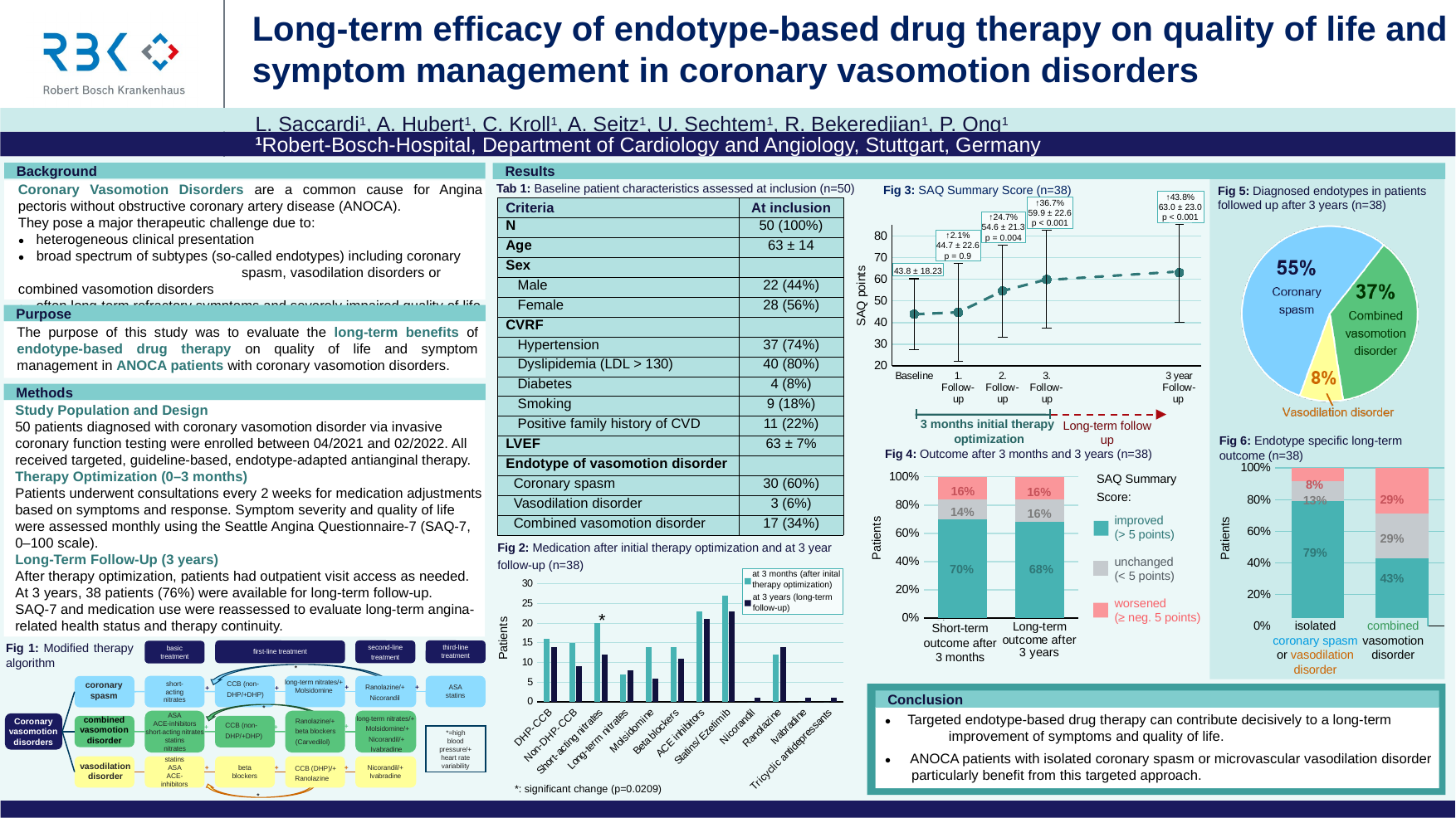
In Fig 3, what is the SAQ Summary Score at baseline? 43.8 ± 18.23 In Fig 5, which endotype has the smallest share of the pie? Vasodilation disorder How many series does the legend of Fig 4 list? 3 In Fig 4, what is the difference between the improved share in the short-term outcome (3 months) and the long-term outcome (3 years)? 2% In Fig 6, what percentage of patients with combined vasomotion disorder had a worsened outcome? 29% In Fig 2, is the number of patients on Statins/Ezetimib at 3 months greater or less than 25? greater How many slices does the pie chart in Fig 5 have? 3 In Fig 4, what percentage of patients had an improved SAQ Summary Score in the short-term outcome after 3 months? 70% In Fig 3, does the SAQ Summary Score rise or fall from baseline to the 3 year follow-up? rise In Fig 5, what percentage of patients were diagnosed with coronary spasm? 55% In Fig 6, which group has the larger improved share: isolated coronary spasm or vasodilation disorder, or combined vasomotion disorder? isolated coronary spasm or vasodilation disorder What kind of chart is Fig 2? bar chart